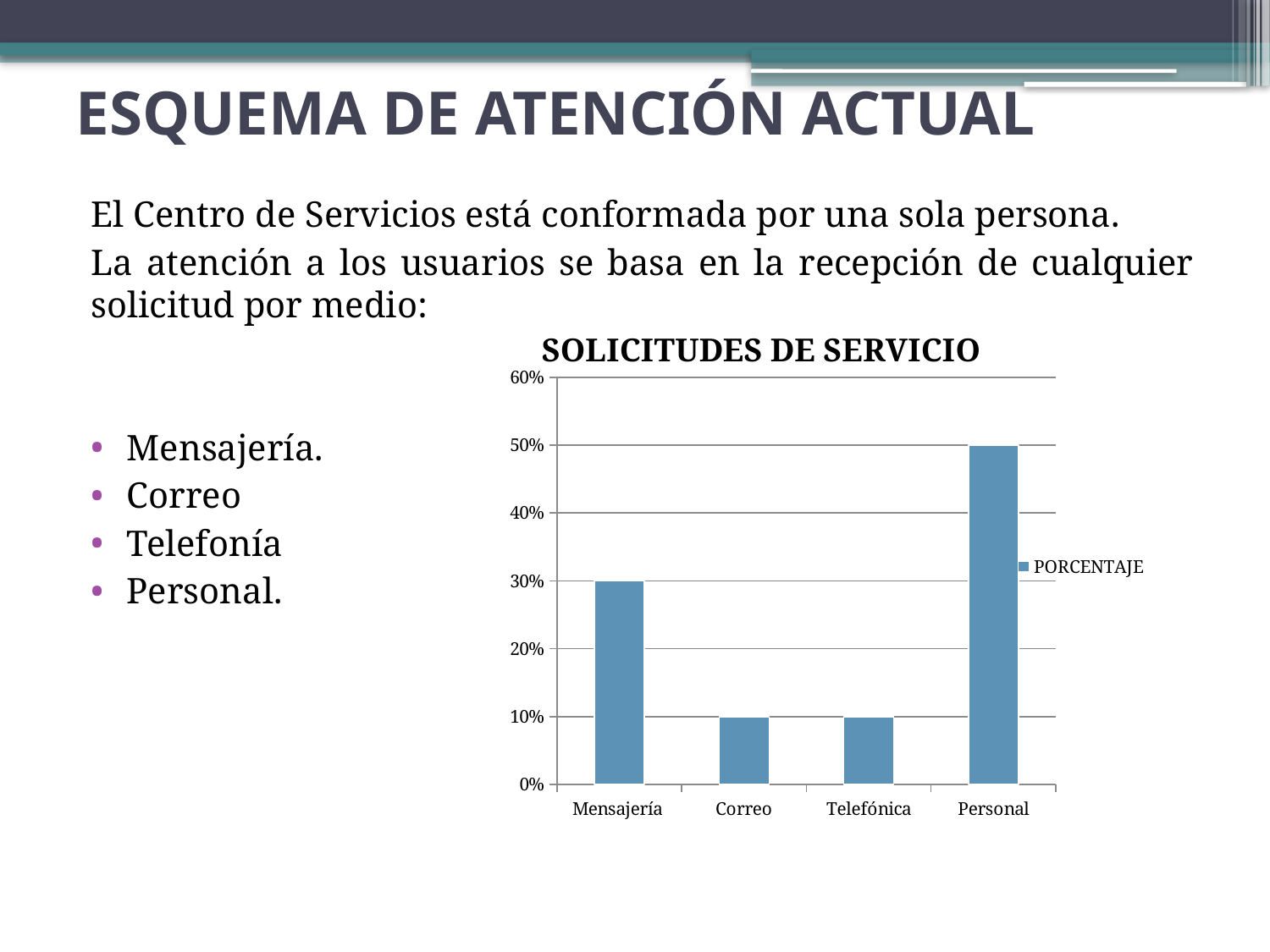
What is the value for Correo? 10% How many series does the chart legend list? 1 What is the title of the chart? SOLICITUDES DE SERVICIO What type of chart is shown on the slide? bar chart What is the value for Personal? 50% Is the value for Personal greater or less than 40%? greater How many categories are shown on the x axis of the chart? 4 What is the name of the series shown in the legend? PORCENTAJE Which is larger, the value for Mensajería or the value for Telefónica? Mensajería What is the difference between the value for Personal and the value for Mensajería? 20% What is the value for Mensajería? 30% Which category has the highest value? Personal